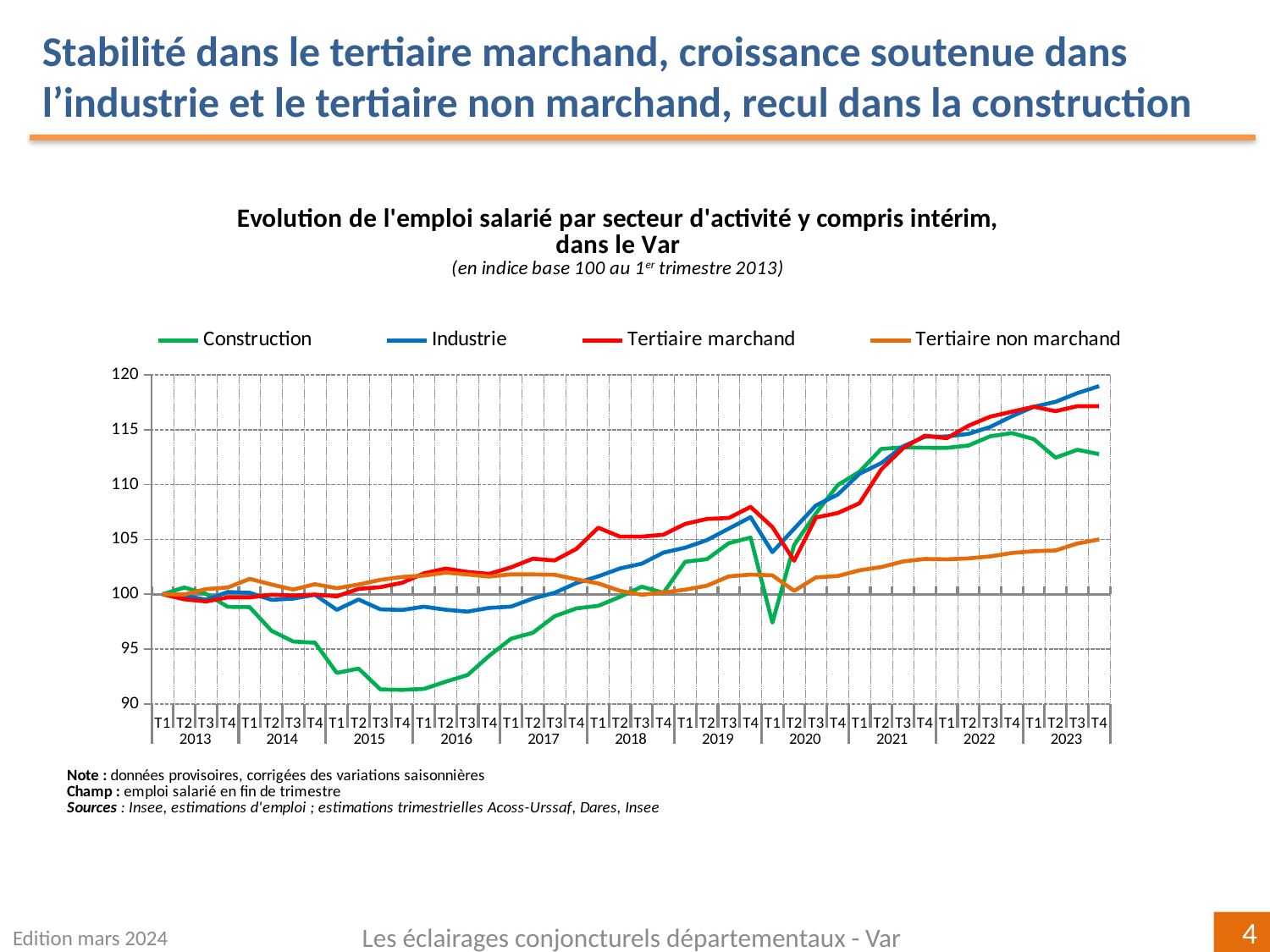
Is the value for Industrie at T4 2023 greater or less than 115? greater Which series has the highest value at T4 2023? Industrie At T4 2023, which is larger: Industrie or Construction? Industrie Is the value for Construction at T1 2020 greater or less than 100? less What kind of chart is shown on the slide? line chart How many series does the legend list? 4 Which colour is used for the Construction series? green What is the value of the Industrie series at T1 2013? 100 Which series has the lowest value at T4 2023? Tertiaire non marchand Does the Construction series rise or fall between T1 2013 and T4 2015? fall Is the value for Construction at T4 2015 greater or less than 95? less Which series has the lowest value at T4 2015? Construction